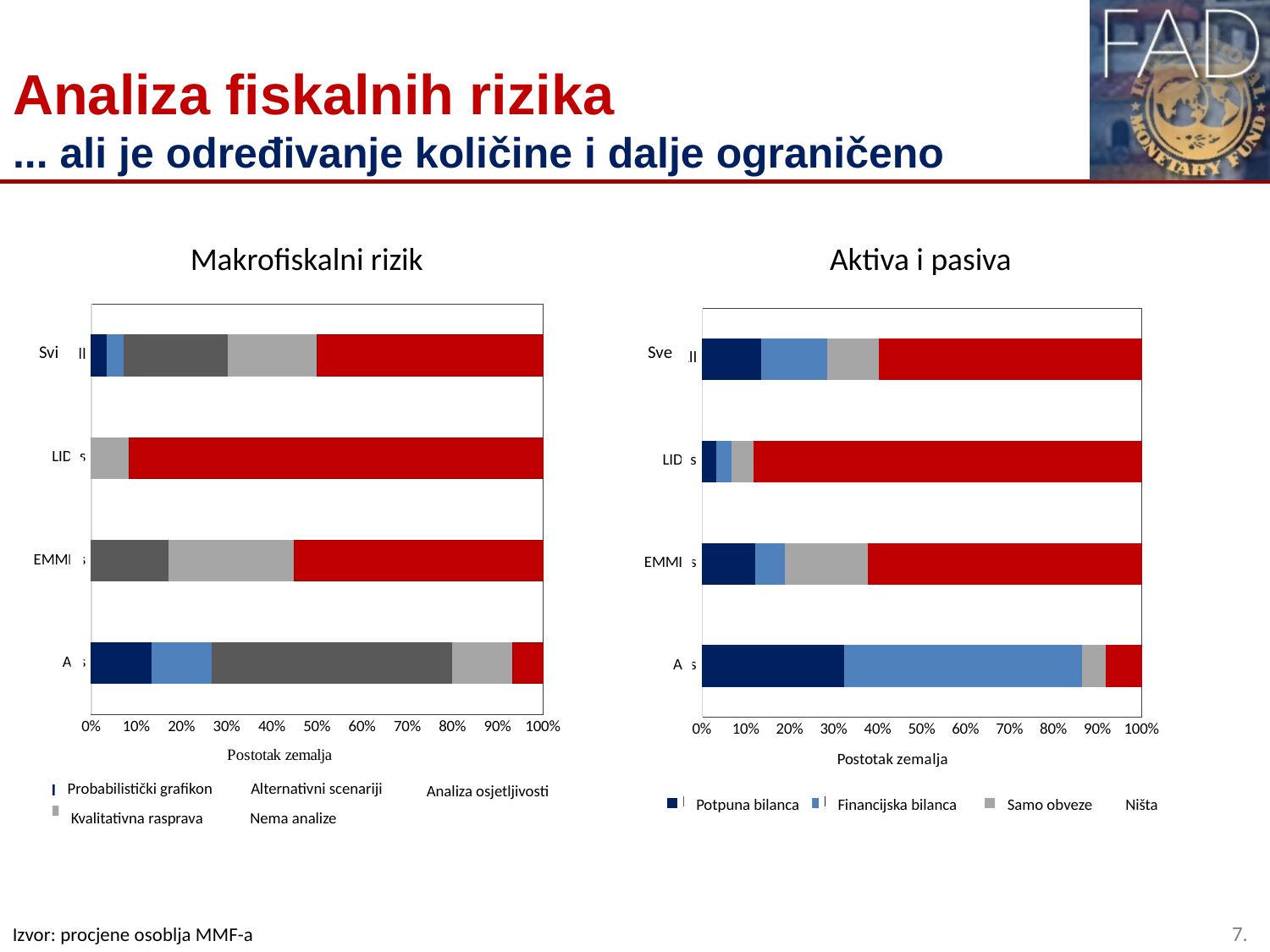
In the 'Makrofiskalni rizik' chart, is the 'Nema analize' share for LID greater or less than 80%? greater What is the title of the chart on the right side of the slide? Aktiva i pasiva In the 'Aktiva i pasiva' chart, is the 'Ništa' share for A greater or less than 20%? less How many series does the legend of the 'Aktiva i pasiva' chart list? 4 What is the x-axis label of the 'Makrofiskalni rizik' chart? Postotak zemalja In the 'Makrofiskalni rizik' chart, which category has the larger 'Nema analize' share, LID or A? LID How many country-group categories are shown on the 'Aktiva i pasiva' chart? 4 What kind of chart is the 'Makrofiskalni rizik' chart? stacked bar chart How many series does the legend of the 'Makrofiskalni rizik' chart list? 5 In the 'Aktiva i pasiva' chart, is the 'Potpuna bilanca' share for Sve greater or less than 20%? less